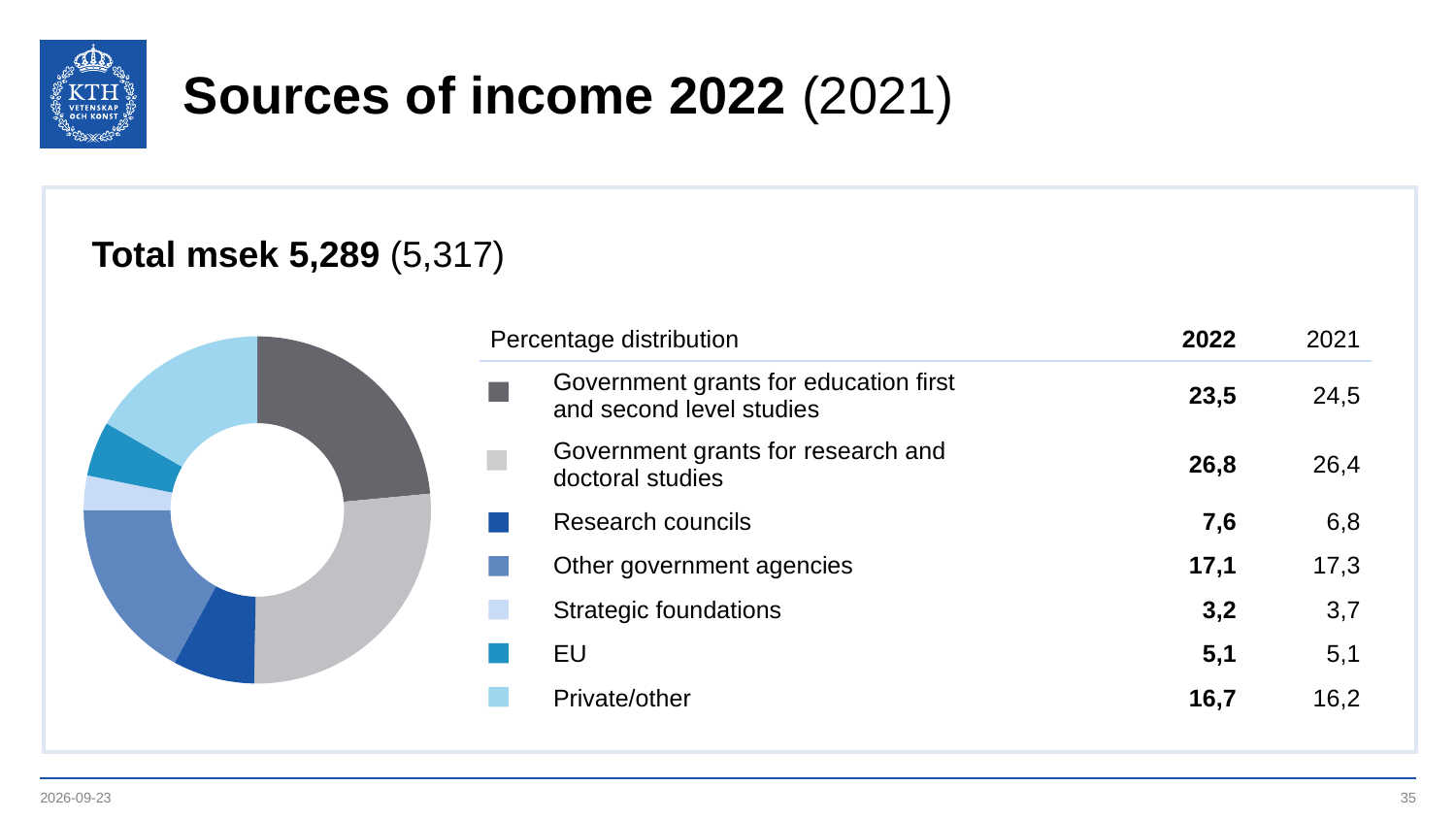
Which is larger in 2022: Other government agencies or Private/other? Other government agencies What is the 2022 percentage for Research councils? 7,6 Which category is shown in dark grey in the chart? Government grants for education first and second level studies Which category has the smallest share in 2022? Strategic foundations What is the difference between the 2022 percentages for Government grants for research and doctoral studies and Government grants for education first and second level studies? 3,3 Which category has the largest share in 2022? Government grants for research and doctoral studies How many categories does the legend list for the chart? 7 What is the 2021 percentage for Private/other? 16,2 What is the 2022 share of the EU slice? 5,1 What kind of chart is shown on the slide? Donut (pie) chart What is the total income in msek for 2022 shown on the slide? 5,289 What is the 2022 percentage for Government grants for research and doctoral studies? 26,8